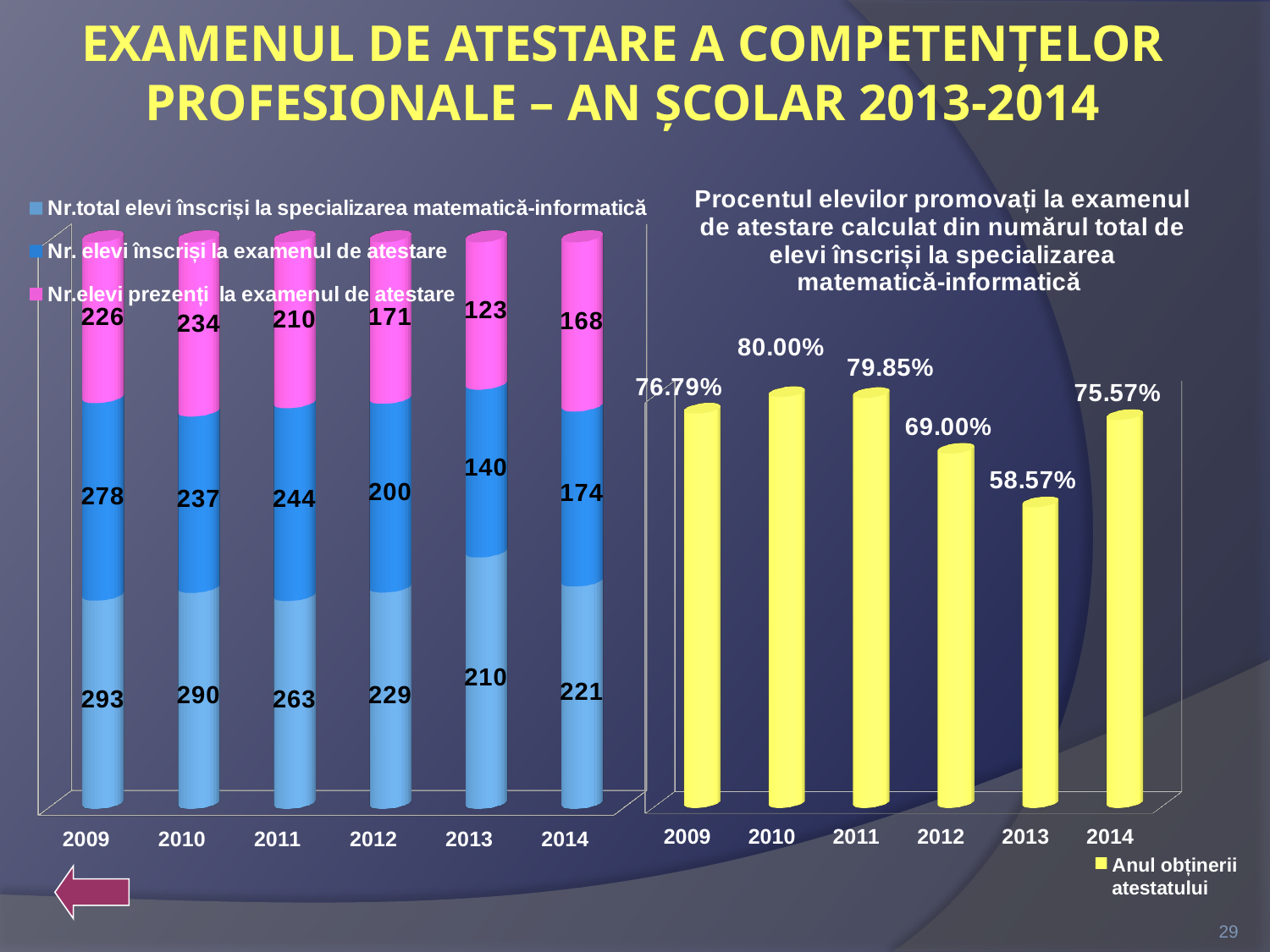
In the left chart, what is the difference between the 'Nr. elevi înscriși la examenul de atestare' values for 2009 and 2010? 41 How many years are shown on the x axis of the right chart? 6 In the left chart, which year has the lowest value for 'Nr.elevi prezenți la examenul de atestare'? 2013 In the right chart 'Procentul elevilor promovați la examenul de atestare...', which year has the lowest value? 2013 In the left chart, what is the total of the stacked bar for 2013? 473 In the right chart 'Procentul elevilor promovați la examenul de atestare...', which is larger, the value for 2009 or the value for 2014? 2009 In the left chart, what is the value of 'Nr.elevi prezenți la examenul de atestare' for 2014? 168 In the right chart 'Procentul elevilor promovați la examenul de atestare...', what is the value for 2012? 69.00% In the left chart, what is the value of 'Nr.total elevi înscriși la specializarea matematică-informatică' for 2009? 293 In the left chart, what is the value of 'Nr. elevi înscriși la examenul de atestare' for 2013? 140 How many series does the legend of the left chart list? 3 In the right chart 'Procentul elevilor promovați la examenul de atestare...', which year has the highest value? 2010